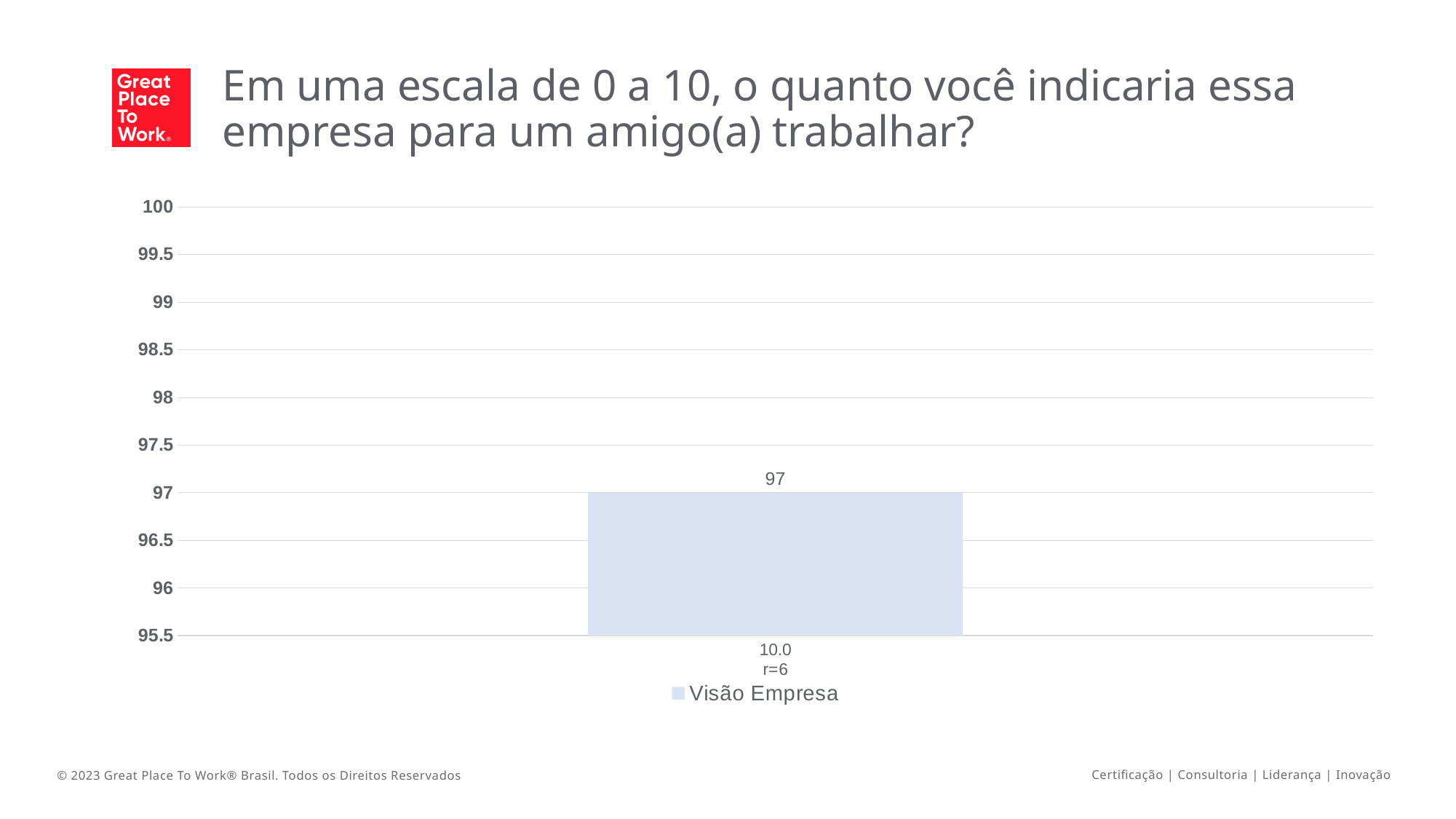
Is the value of the bar greater or less than 96? greater How many series does the legend list? 1 What is the value of the bar labelled "10.0 r=6"? 97 What kind of chart is shown on the slide? bar chart Is the value of the bar greater or less than 98? less How many bars are plotted in the chart? 1 What is the lowest value shown on the vertical axis? 95.5 What is the name of the series shown in the legend? Visão Empresa What is the highest value shown on the vertical axis? 100 What is the category label under the bar? 10.0 r=6